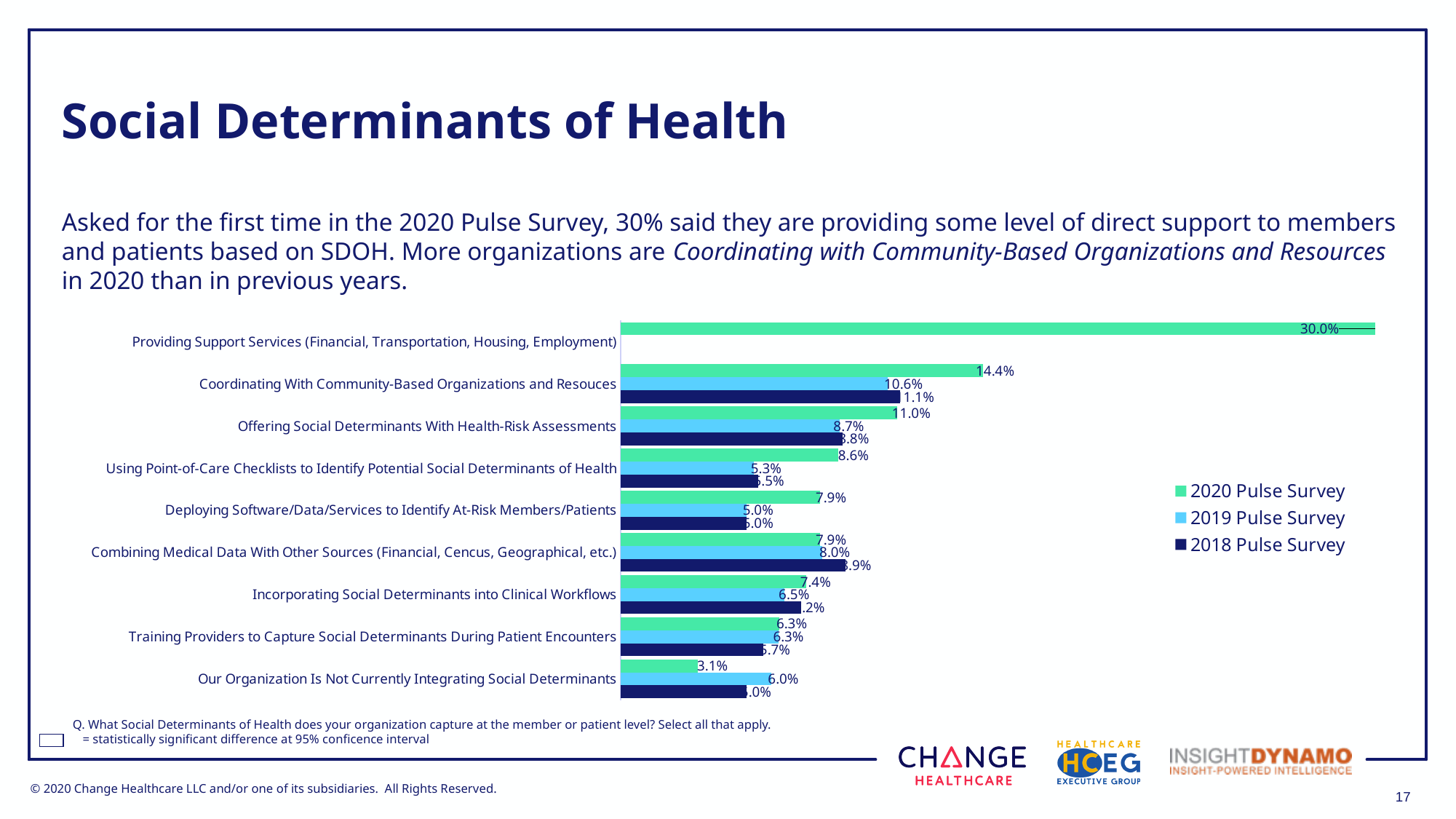
What is the 2020 Pulse Survey value for Coordinating With Community-Based Organizations and Resouces? 14.4% What kind of chart is shown on the slide? Bar chart What is the 2020 Pulse Survey value for Providing Support Services (Financial, Transportation, Housing, Employment)? 30.0% How many categories are shown on the chart? 9 What is the 2020 Pulse Survey value for Offering Social Determinants With Health-Risk Assessments? 11.0% What is the 2019 Pulse Survey value for Coordinating With Community-Based Organizations and Resouces? 10.6% For Coordinating With Community-Based Organizations and Resouces, how much higher is the 2020 Pulse Survey value than the 2019 Pulse Survey value? 3.8 percentage points For Using Point-of-Care Checklists to Identify Potential Social Determinants of Health, which is larger: the 2020 Pulse Survey value or the 2019 Pulse Survey value? 2020 Pulse Survey Which category has the highest 2020 Pulse Survey value? Providing Support Services (Financial, Transportation, Housing, Employment) Which category has the lowest 2020 Pulse Survey value? Our Organization Is Not Currently Integrating Social Determinants How many series does the legend list? 3 What is the 2019 Pulse Survey value for Our Organization Is Not Currently Integrating Social Determinants? 6.0%